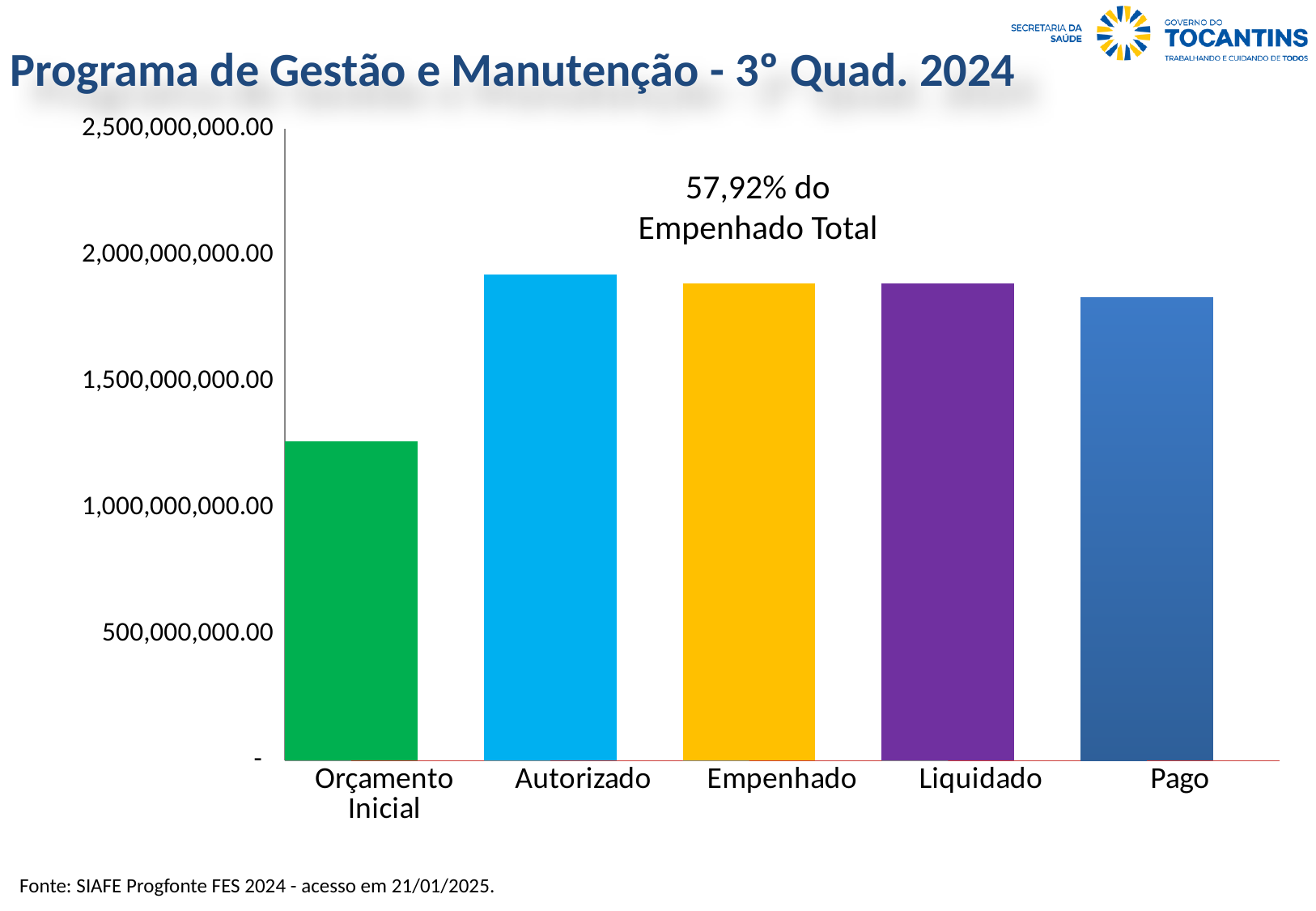
What kind of chart is shown on the slide? bar chart What percentage annotation is printed above the bars in the chart? 57,92% do Empenhado Total Which category has the highest value in the chart? Autorizado What is the title of the slide containing the chart? Programa de Gestão e Manutenção - 3° Quad. 2024 Is the value for Orçamento Inicial greater or less than 1,000,000,000.00? greater Is the value for Autorizado greater or less than 2,000,000,000.00? less Is the value for Orçamento Inicial greater or less than 1,500,000,000.00? less Which is larger, the value for Autorizado or the value for Pago? Autorizado Which category has the lowest value in the chart? Orçamento Inicial How many categories are shown on the x axis of the chart? 5 Which is larger, the value for Orçamento Inicial or the value for Autorizado? Autorizado